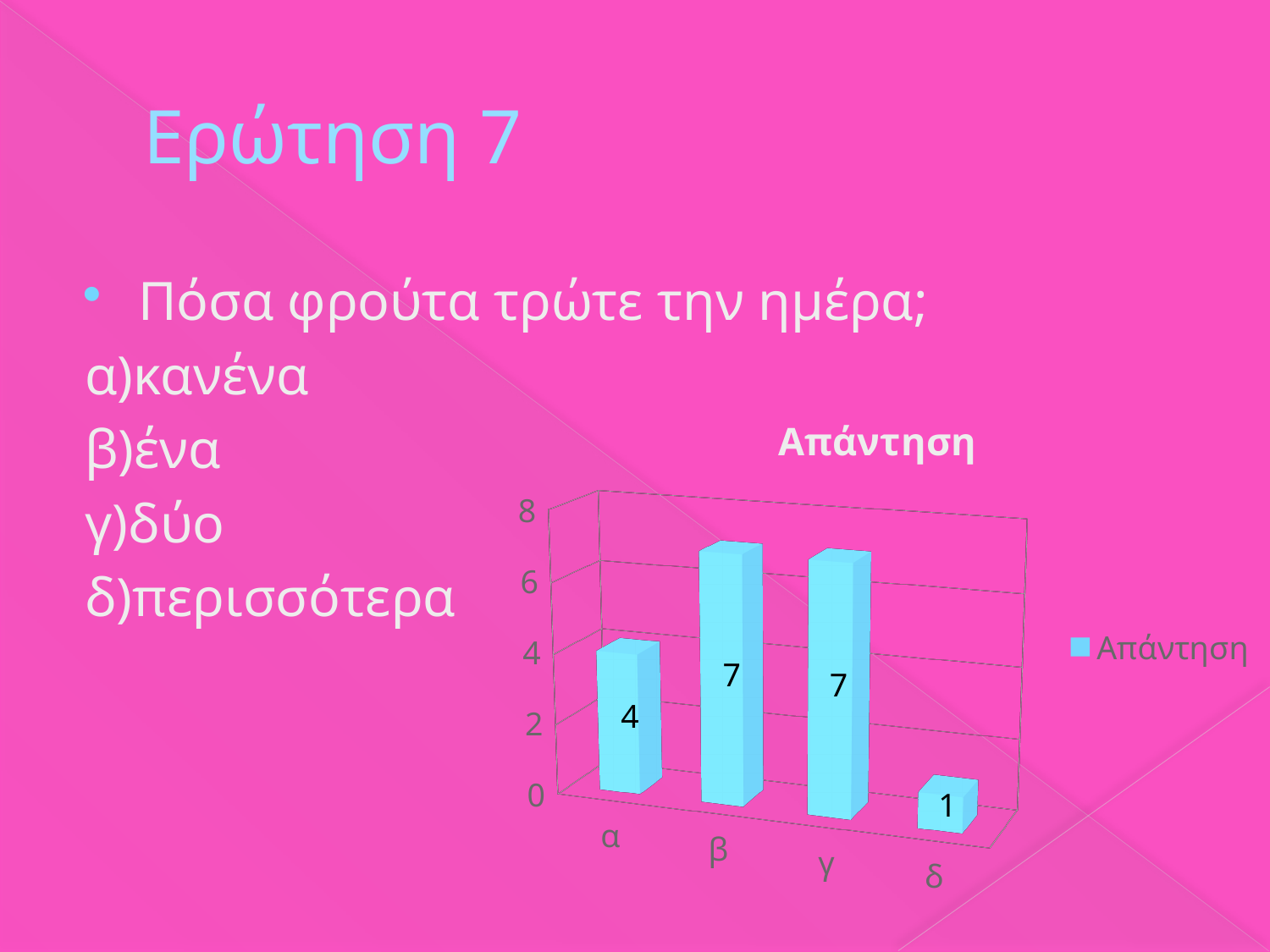
Is the value for β greater or less than 6? greater How many categories are shown on the x axis? 4 What is the value for category α? 4 What kind of chart is shown? bar chart Which is larger, the value for α or the value for δ? α What is the title of the chart? Απάντηση Which category has the lowest value? δ What is the difference between the values for β and δ? 6 How many series does the legend list? 1 What is the value for category β? 7 What is the value for category δ? 1 What is the difference between the values for γ and α? 3